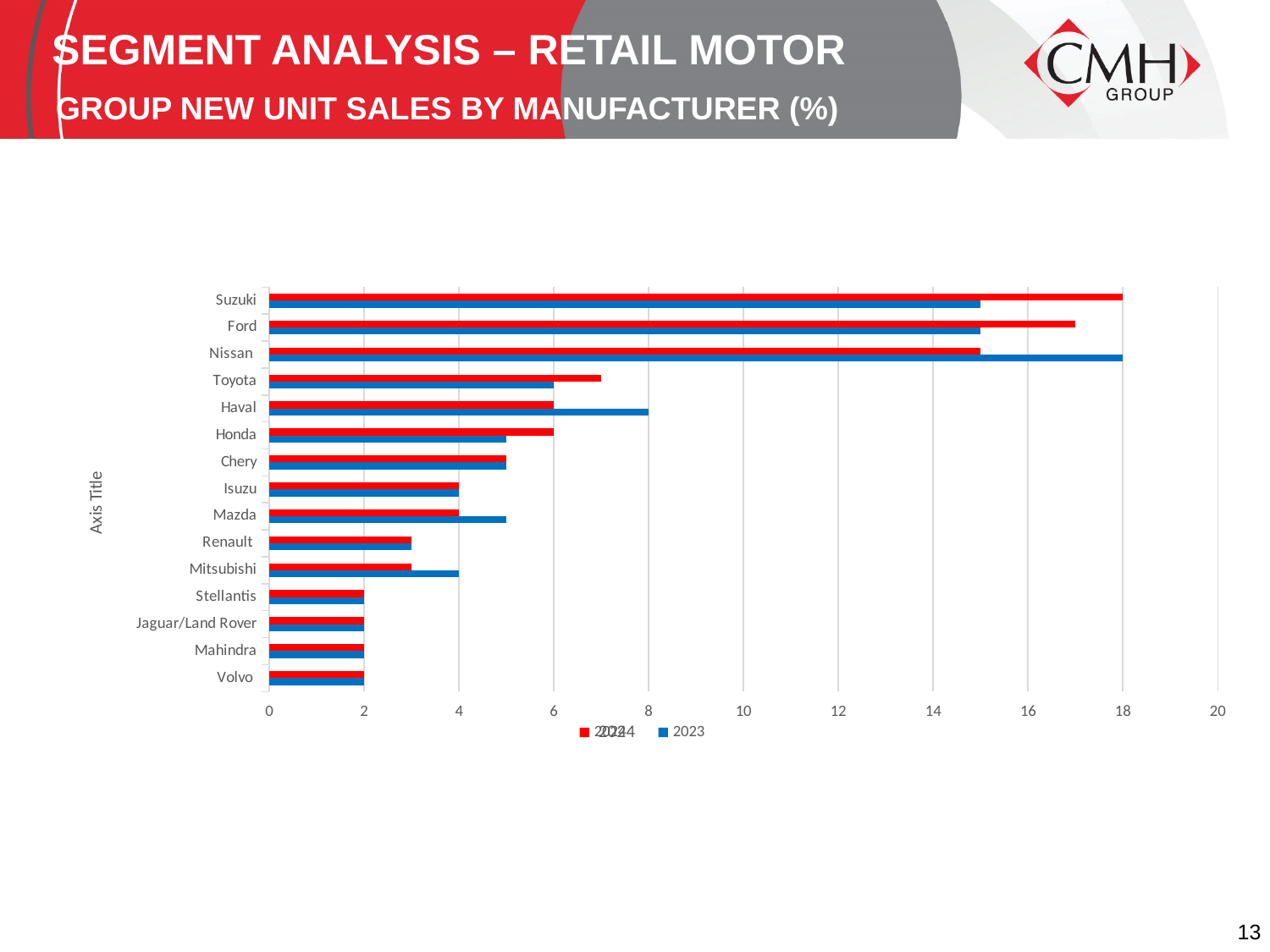
What kind of chart is shown on the slide? Bar chart Which manufacturer has the highest 2023 (blue) value? Nissan What is the label shown on the vertical axis? Axis Title Which manufacturer has the highest red (2024) value? Suzuki What is the 2023 (blue) value for Haval? 8 For Haval, which is larger: the 2023 (blue) value or the red (2024) value? 2023 What is the 2023 (blue) value for Nissan? 18 What is the red (2024) value for Suzuki? 18 What is the red (2024) value for Volvo? 2 What is the difference between Haval's 2023 (blue) value and its red (2024) value? 2 Is the red (2024) value for Ford greater or less than 16? greater How many manufacturers are listed on the chart? 15